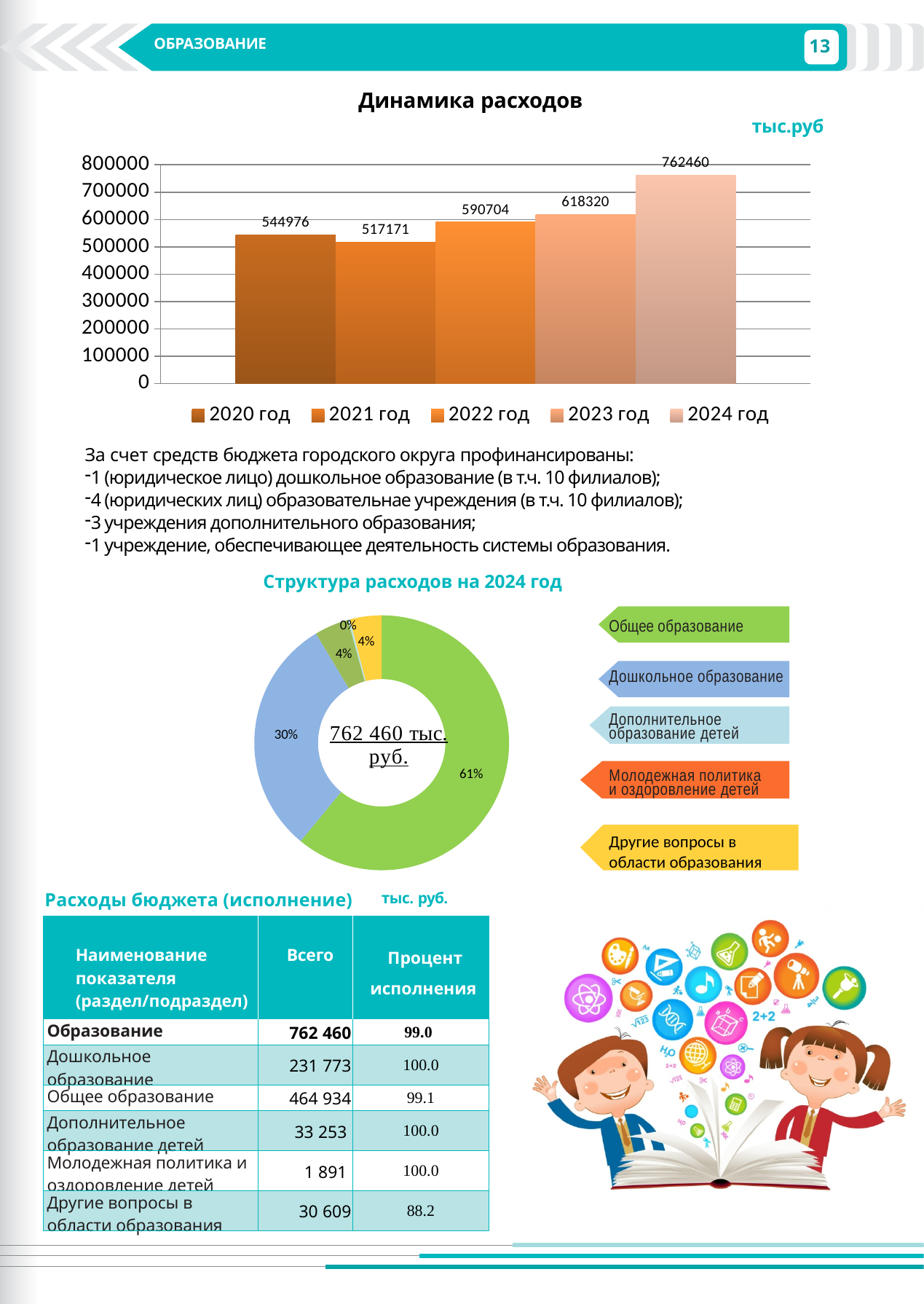
How many categories does the legend of the 'Структура расходов на 2024 год' chart list? 5 In the 'Динамика расходов' chart, which year has the lowest value? 2021 год In the 'Динамика расходов' chart, is the value for 2023 год greater or less than 700000? less In the 'Динамика расходов' chart, which year has the highest value? 2024 год In the 'Динамика расходов' chart, what is the difference between the values for 2024 год and 2023 год? 144140 In the 'Динамика расходов' chart, what is the value for 2024 год? 762460 What kind of chart is 'Динамика расходов'? bar chart In the 'Структура расходов на 2024 год' chart, what share does Общее образование have? 61% In the 'Структура расходов на 2024 год' chart, what share does Дошкольное образование have? 30% In the 'Динамика расходов' chart, which is larger: the value for 2020 год or 2022 год? 2022 год In the 'Динамика расходов' chart, how many years are plotted? 5 In the 'Динамика расходов' chart, what is the value for 2021 год? 517171